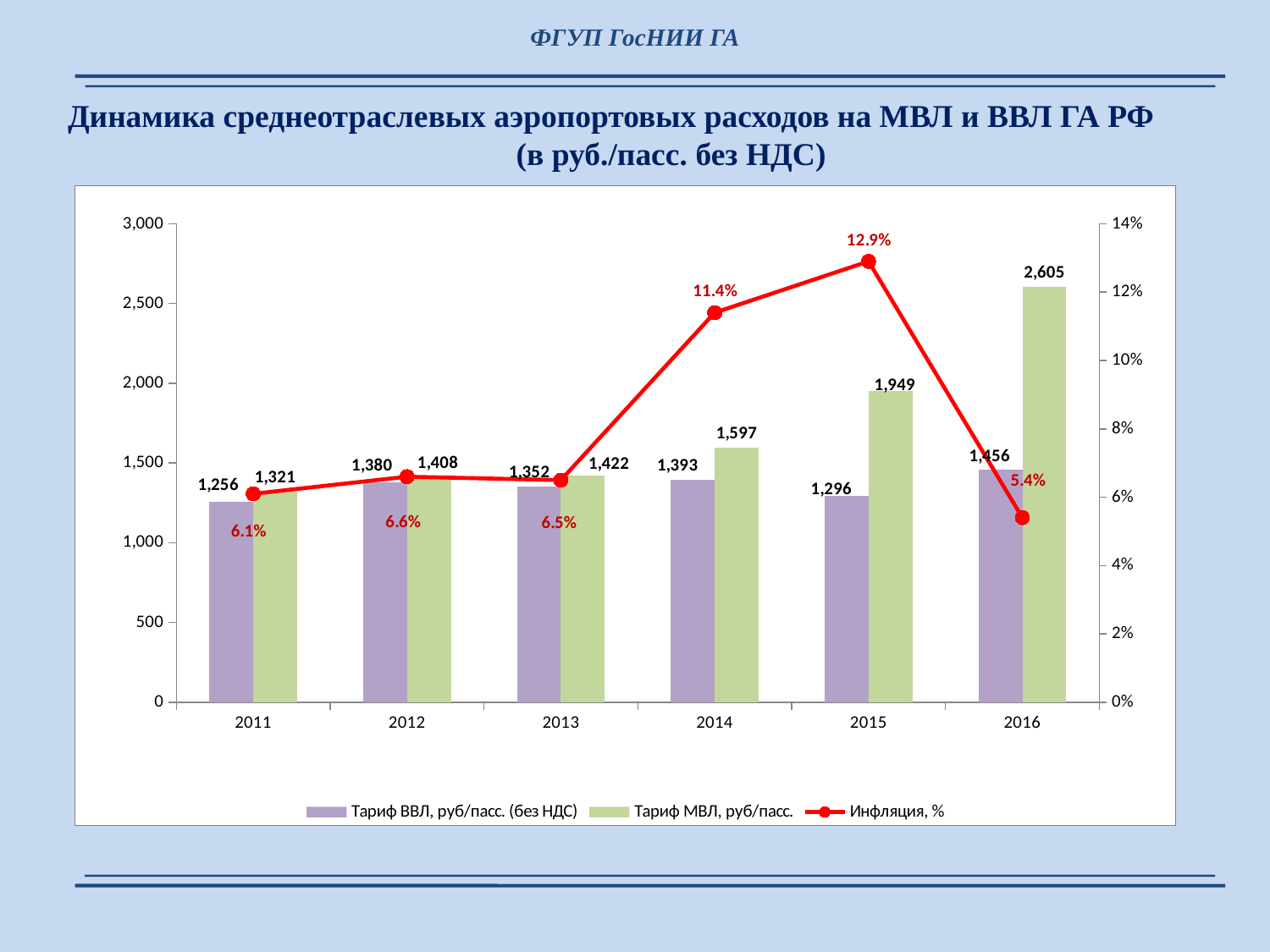
How many years are shown on the x axis? 6 What is the Инфляция, % value for 2015? 12.9% What is the difference between Тариф МВЛ and Тариф ВВЛ in 2015? 653 Which is larger in 2014: Тариф ВВЛ or Тариф МВЛ? Тариф МВЛ How many series does the legend list? 3 In which year is Тариф ВВЛ, руб/пасс. (без НДС) the lowest? 2011 In which year is Тариф МВЛ, руб/пасс. the highest? 2016 What is the value of Тариф МВЛ, руб/пасс. for 2016? 2,605 What colour is the Инфляция, % line? red In which year is Инфляция, % the lowest? 2016 Does Тариф МВЛ, руб/пасс. rise or fall from 2011 to 2016? rise What is the value of Тариф ВВЛ, руб/пасс. (без НДС) for 2011? 1,256